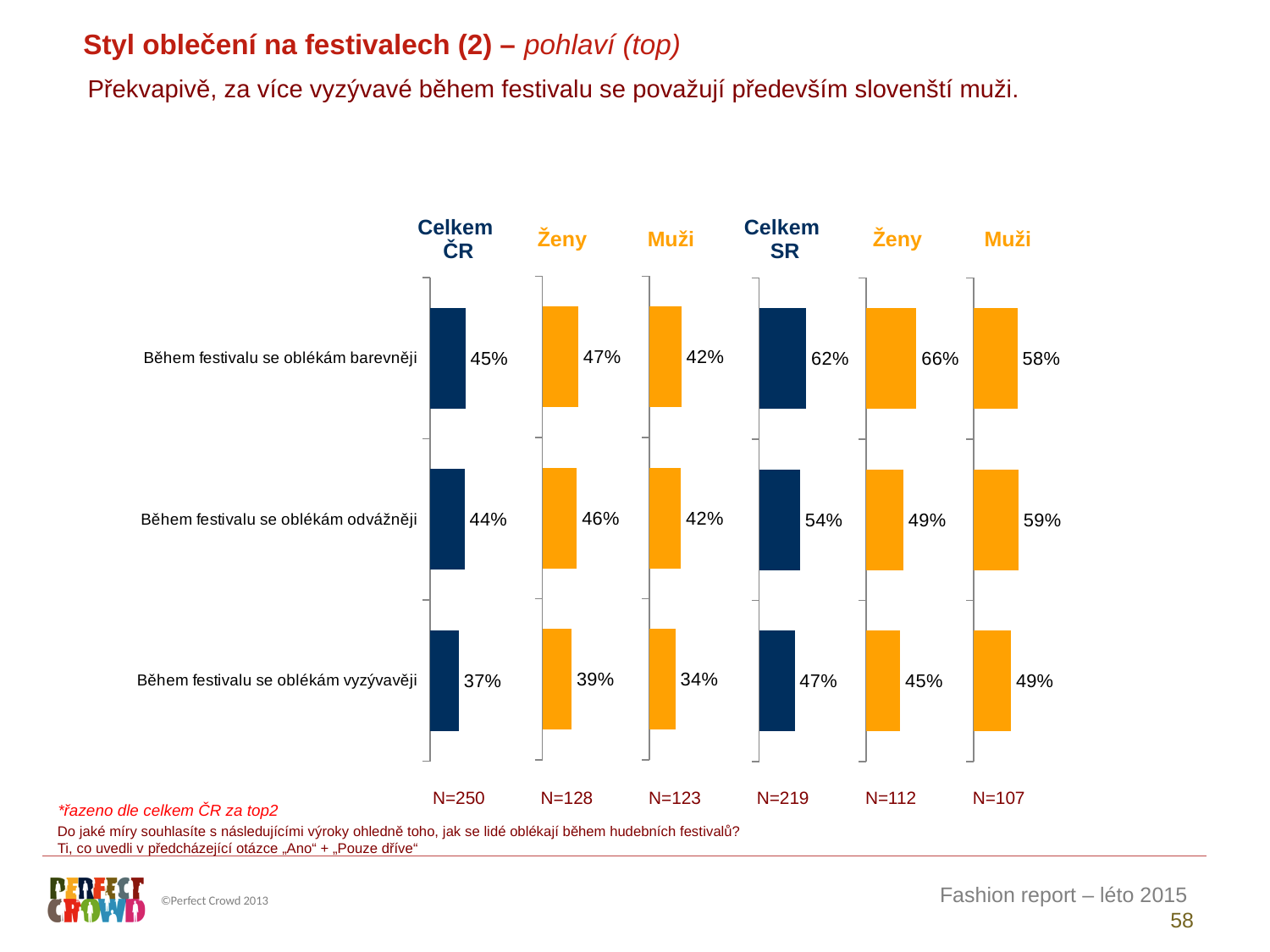
In the Muži chart on the far right (SR group), what is the value for "Během festivalu se oblékám odvážněji"? 59% For "Během festivalu se oblékám vyzývavěji", which is larger: the Muži value in the ČR group or the Muži value in the SR group? Muži in the SR group (49%) In the Celkem SR chart, what is the value for "Během festivalu se oblékám vyzývavěji"? 47% How many separate bar charts are shown on the slide? 6 What is the difference between the Celkem SR value and the Celkem ČR value for "Během festivalu se oblékám barevněji"? 17 percentage points What type of chart is used on the slide? Bar chart In the Celkem ČR chart, which statement has the lowest value? Během festivalu se oblékám vyzývavěji How many statements (categories) are shown in each chart? 3 In the Ženy chart of the SR group (fifth chart from the left), which statement has the highest value? Během festivalu se oblékám barevněji In the Celkem ČR chart, what is the value for "Během festivalu se oblékám barevněji"? 45% What is the sample size (N) shown under the Celkem SR chart? N=219 In the Ženy chart of the ČR group (second chart from the left), what is the difference between "Během festivalu se oblékám barevněji" and "Během festivalu se oblékám vyzývavěji"? 8 percentage points